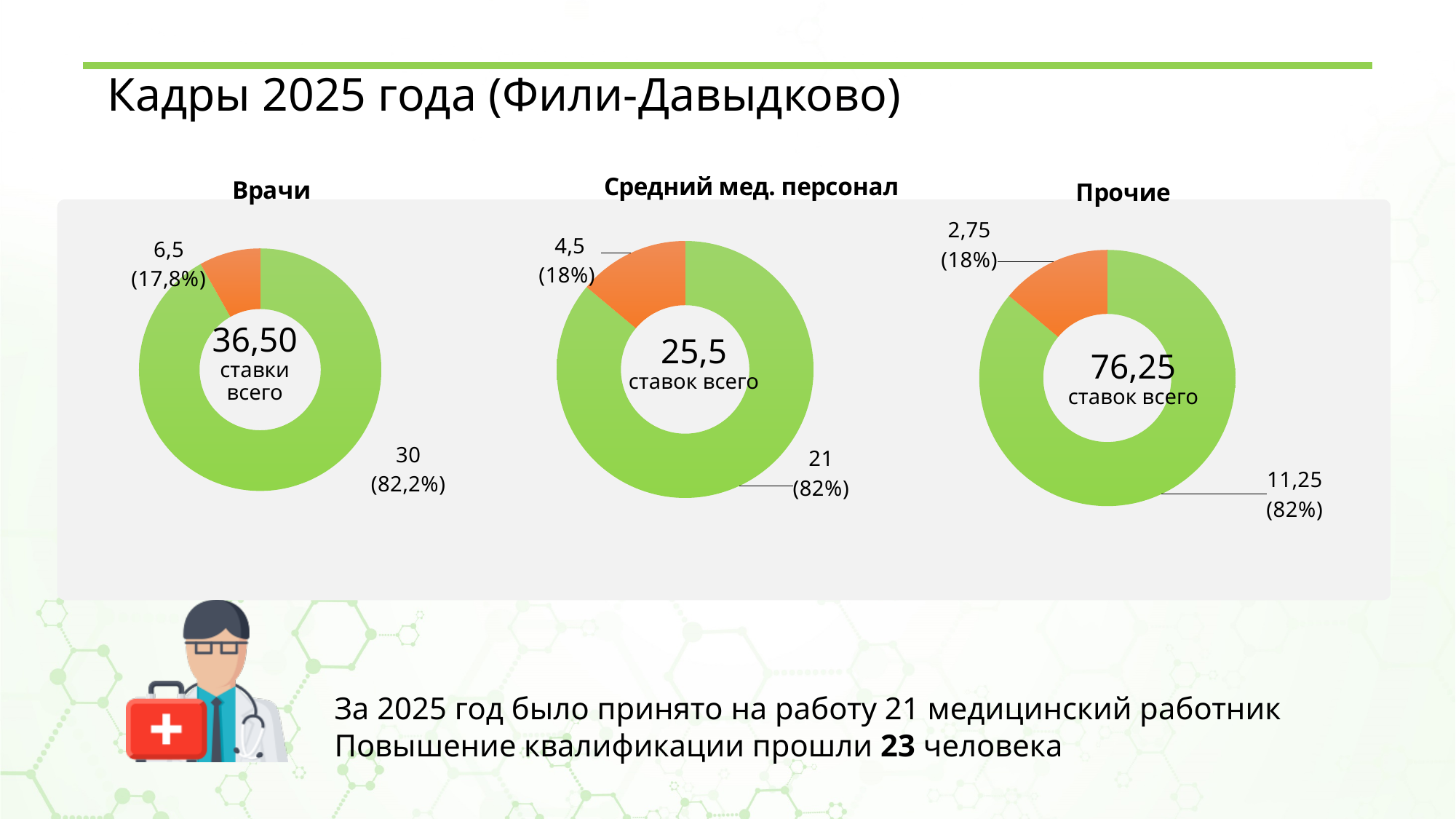
In the "Врачи" chart, what total is shown in the centre of the donut? 36,50 ставки всего How many donut charts are shown on the slide? 3 In the "Средний мед. персонал" chart, what value is labelled on the green slice? 21 In the "Прочие" chart, what value is labelled on the green slice? 11,25 In the "Прочие" chart, what value is labelled on the orange slice? 2,75 In the "Врачи" chart, what share of the total does the green slice represent? 82,2% What kind of chart is used for the "Врачи" chart? Donut (pie) chart In the "Средний мед. персонал" chart, what total is shown in the centre of the donut? 25,5 ставок всего In the "Прочие" chart, which slice is larger, the green one or the orange one? The green one In the "Врачи" chart, what value is labelled on the orange slice? 6,5 In the "Средний мед. персонал" chart, what is the difference between the green slice value and the orange slice value? 16,5 In the "Средний мед. персонал" chart, what share of the total does the orange slice represent? 18%